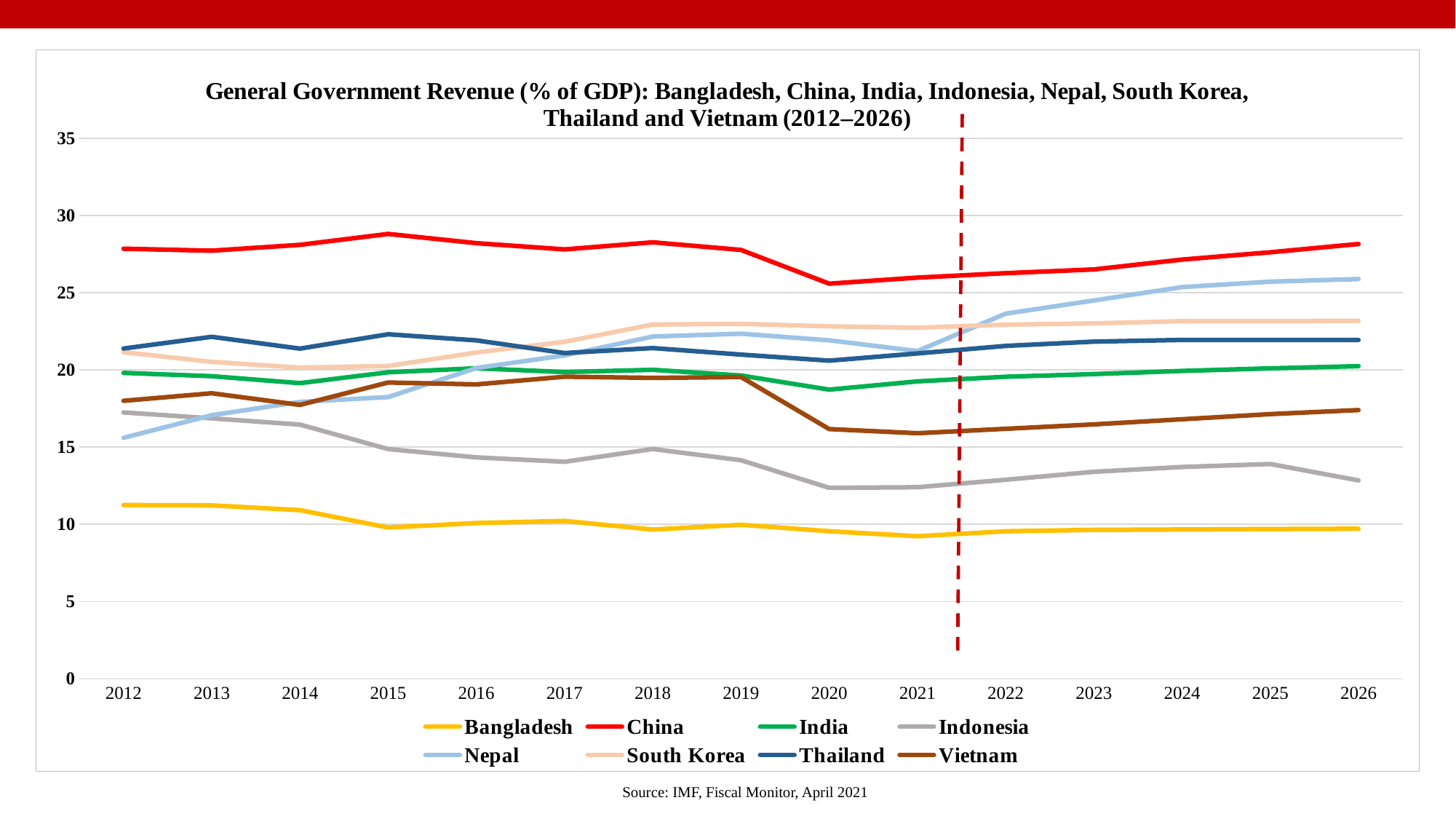
Which country has the highest general government revenue (% of GDP) in 2012? China Is the value for Nepal in 2012 greater or less than 20? less What kind of chart is shown on the slide? Line chart In 2020, which is larger: the value for India or the value for Vietnam? India In 2026, which is larger: the value for Nepal or the value for Indonesia? Nepal Is the value for China in 2015 greater or less than 25? greater How many series does the legend list? 8 Which country has the lowest general government revenue (% of GDP) in 2026? Bangladesh Does the value for Indonesia rise or fall from 2012 to 2020? fall What source is cited below the chart? IMF, Fiscal Monitor, April 2021 How many years are shown along the x axis? 15 Is the value for Bangladesh in 2021 greater or less than 10? less